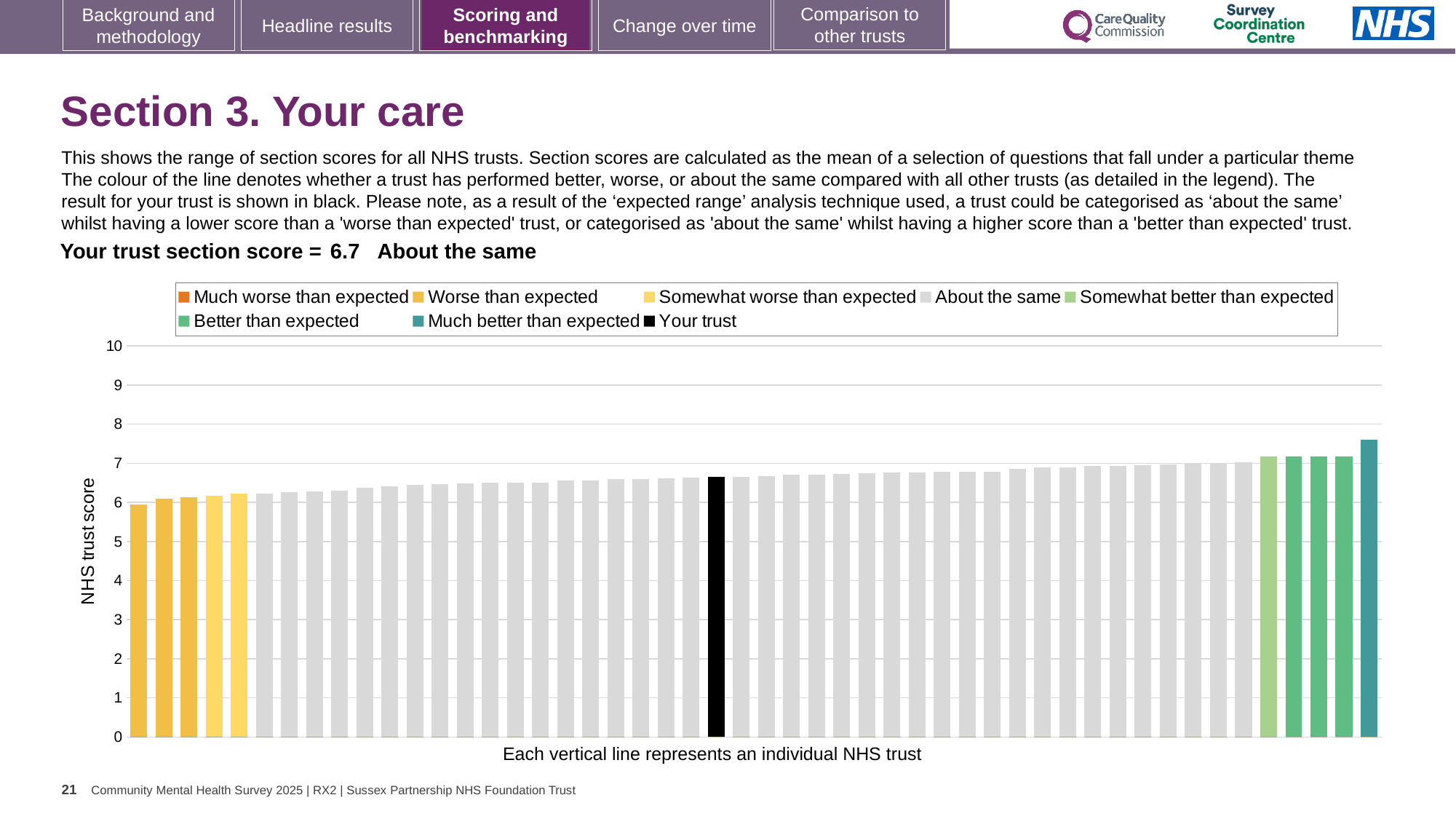
Which legend category does the tallest bar in the chart belong to? Much better than expected Is the value of the tallest bar in the chart greater or less than 8? less Is the value of the shortest bar in the chart greater or less than 7? less What is the section score for your trust shown on the slide? 6.7 Which category is your trust's section score placed in? About the same How many entries does the chart legend list? 8 What colour is the bar representing your trust? Black Do the bar values rise or fall from left to right along the x axis? Rise What kind of chart is shown on the slide? Bar chart What is the title of the vertical axis? NHS trust score Is the value of the black 'Your trust' bar greater or less than 6? greater